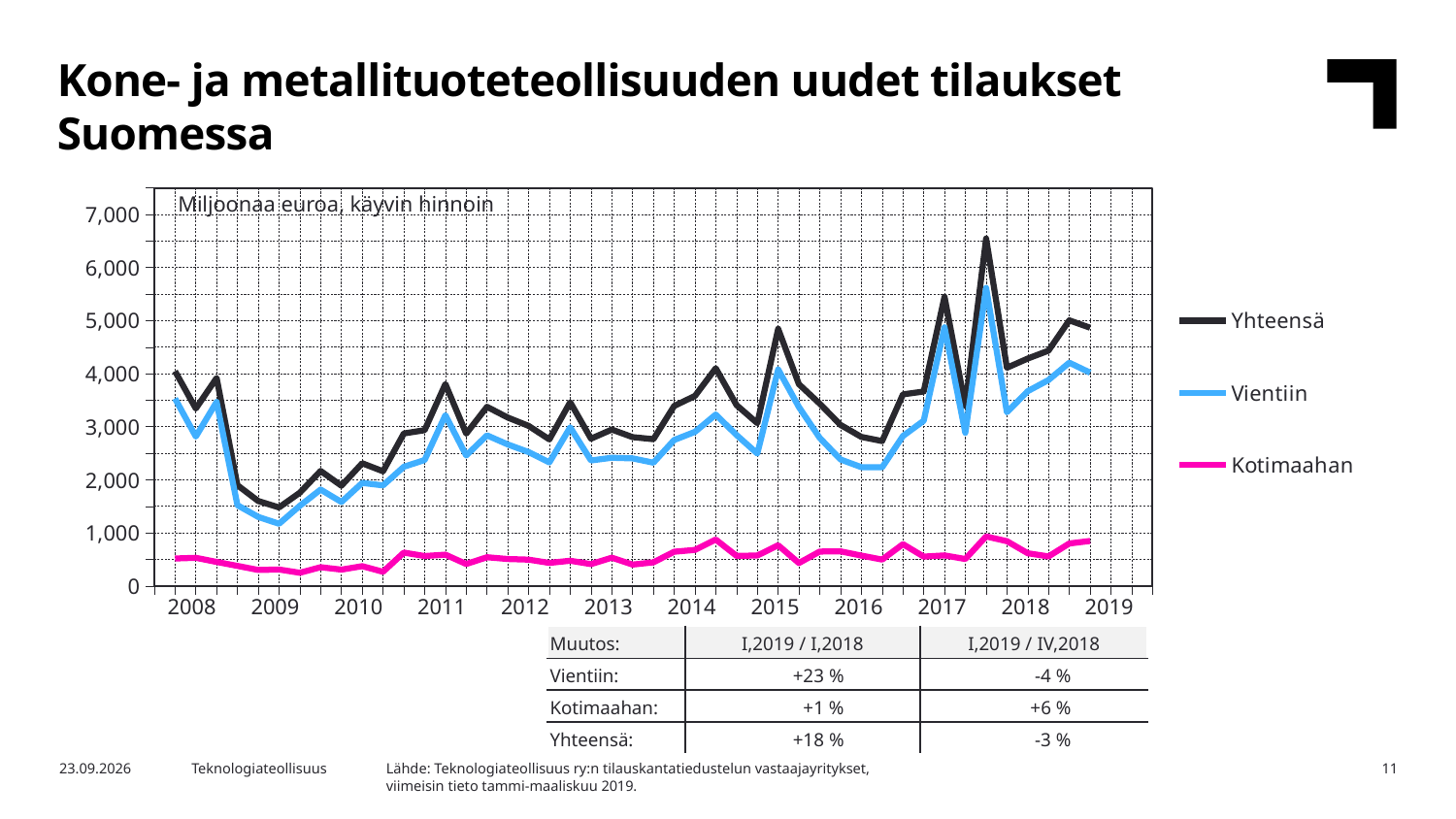
In 2015, which is larger, the value for Vientiin or the value for Kotimaahan? Vientiin Which series has the lowest values throughout the chart? Kotimaahan Is the value for Yhteensä at the start of 2008 greater or less than 3,000? greater Is the value for Vientiin at the start of 2009 greater or less than 2,000? less Is the value for Kotimaahan at the start of 2008 greater or less than 1,000? less Which series has the highest values throughout the chart? Yhteensä What kind of chart is shown on the slide? line chart What unit label is printed inside the chart area? Miljoonaa euroa, käyvin hinnoin How many series does the chart legend list? 3 What are the three series named in the chart legend? Yhteensä, Vientiin, Kotimaahan Does the Yhteensä line rise or fall between 2008 and 2009? fall